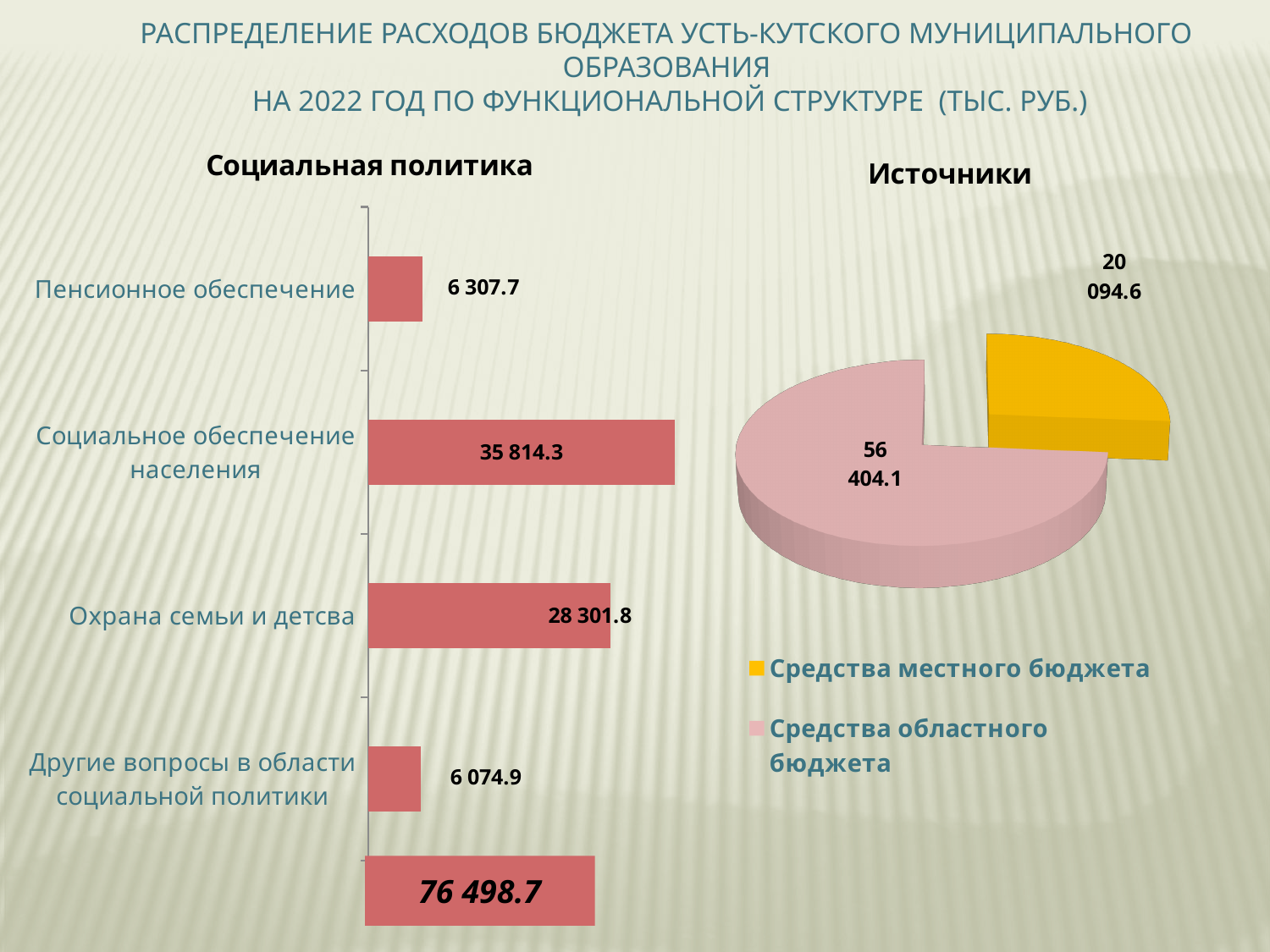
In the 'Источники' pie chart, what is the value for 'Средства областного бюджета'? 56 404.1 In the 'Социальная политика' chart, what is the value for 'Социальное обеспечение населения'? 35 814.3 In the 'Социальная политика' chart, what is the value for 'Охрана семьи и детсва'? 28 301.8 In the 'Социальная политика' chart, which category has the highest value? Социальное обеспечение населения In the 'Источники' pie chart, which is larger: 'Средства местного бюджета' or 'Средства областного бюджета'? Средства областного бюджета What kind of chart is the 'Социальная политика' chart? Bar chart In the 'Социальная политика' chart, what is the value for 'Пенсионное обеспечение'? 6 307.7 In the 'Источники' pie chart, what is the value for 'Средства местного бюджета'? 20 094.6 In the 'Социальная политика' chart, which category has the lowest value? Другие вопросы в области социальной политики In the 'Социальная политика' chart, what is the difference between 'Социальное обеспечение населения' and 'Охрана семьи и детсва'? 7 512.5 In the 'Источники' pie chart, how many entries does the legend list? 2 In the 'Социальная политика' chart, how many categories are shown? 4